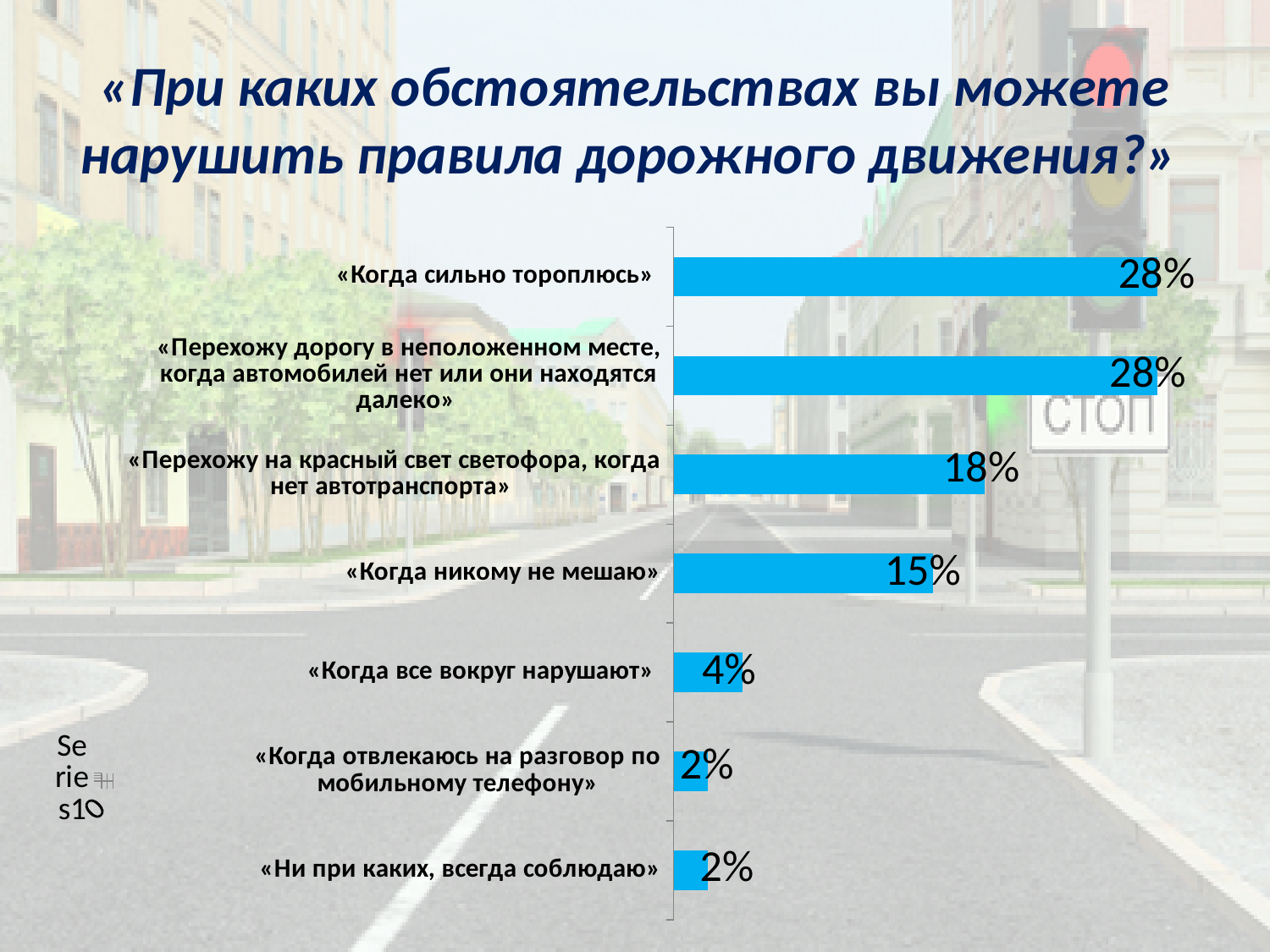
What is the highest value shown in the chart? 28% What is the value for «Перехожу на красный свет светофора, когда нет автотранспорта»? 18% What is the value for «Ни при каких, всегда соблюдаю»? 2% How many categories are shown in the chart? 7 What is the lowest value shown in the chart? 2% What is the difference between the values for «Когда сильно тороплюсь» and «Перехожу на красный свет светофора, когда нет автотранспорта»? 10 percentage points What percentage of respondents chose «Когда сильно тороплюсь»? 28% What kind of chart is shown on the slide? Bar chart What is the value for «Когда никому не мешаю»? 15% Do the values increase or decrease going from the top bar to the bottom bar? Decrease Which is larger: the value for «Когда никому не мешаю» or the value for «Когда все вокруг нарушают»? «Когда никому не мешаю» What is the value for «Когда все вокруг нарушают»? 4%